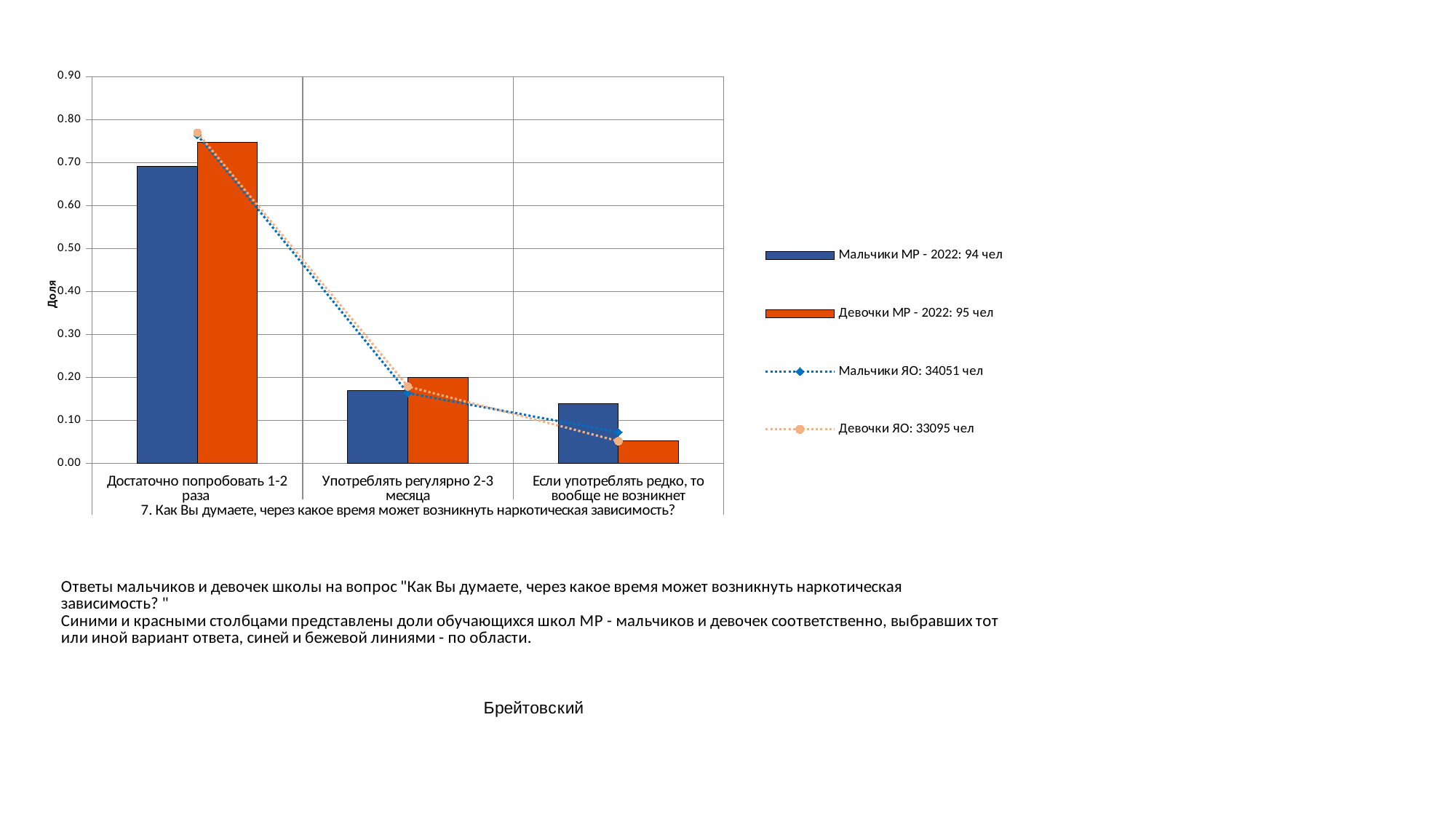
How many series does the legend list? 4 In the category "Достаточно попробовать 1-2 раза", which bar is taller: "Мальчики МР - 2022: 94 чел" or "Девочки МР - 2022: 95 чел"? Девочки МР - 2022: 95 чел What is the label of the vertical axis? Доля Is the value for "Мальчики МР - 2022: 94 чел" in the category "Употреблять регулярно 2-3 месяца" greater or less than 0.20? less Which category has the lowest value for the series "Девочки МР - 2022: 95 чел"? Если употреблять редко, то вообще не возникнет Do the values of the "Девочки ЯО: 33095 чел" line rise or fall from left to right across the categories? fall What kind of chart is shown on the slide? A combined bar and line chart Is the value for "Мальчики МР - 2022: 94 чел" in the category "Достаточно попробовать 1-2 раза" greater or less than 0.60? greater How many answer categories are shown on the x axis? 3 In the category "Если употреблять редко, то вообще не возникнет", which bar is taller: "Мальчики МР - 2022: 94 чел" or "Девочки МР - 2022: 95 чел"? Мальчики МР - 2022: 94 чел Is the value for "Девочки МР - 2022: 95 чел" in the category "Если употреблять редко, то вообще не возникнет" greater or less than 0.10? less Which category has the highest value for the series "Мальчики МР - 2022: 94 чел"? Достаточно попробовать 1-2 раза